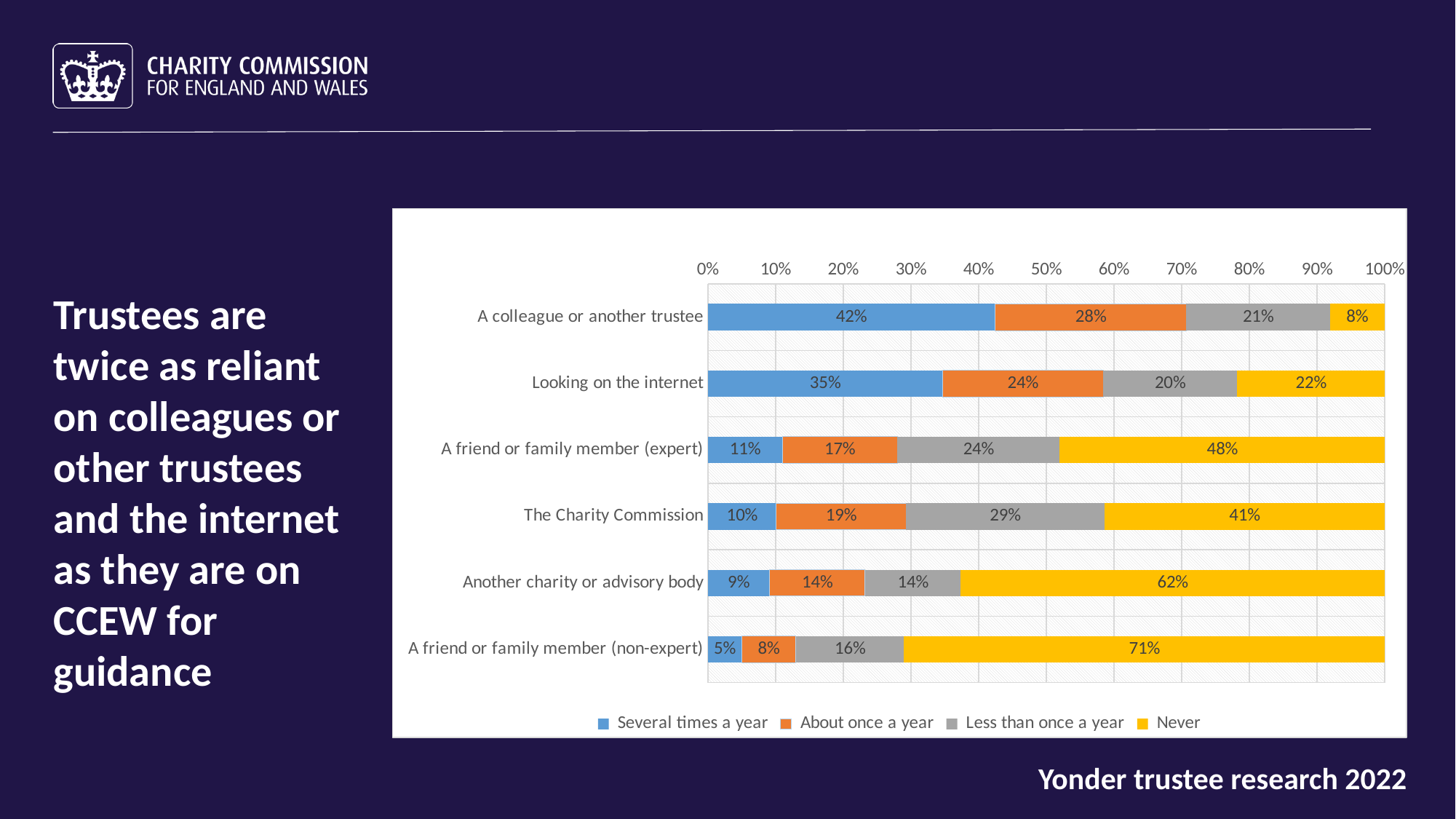
Which source has the highest 'Never' value? A friend or family member (non-expert) What is the 'Less than once a year' value for 'The Charity Commission'? 29% How many series does the legend list? 4 Which source has the highest 'Several times a year' value? A colleague or another trustee How many sources of guidance are listed on the chart? 6 What is the 'Never' value for 'A friend or family member (non-expert)'? 71% What is the difference between the 'Several times a year' values for 'A colleague or another trustee' and 'The Charity Commission'? 32 percentage points Which has the larger 'Never' value: 'Looking on the internet' or 'The Charity Commission'? The Charity Commission Which source has the lowest 'Several times a year' value? A friend or family member (non-expert) What percentage of trustees consult a colleague or another trustee several times a year? 42% What kind of chart is shown on the slide? Stacked bar chart What is the total of the stacked bar for 'A friend or family member (expert)'? 100%